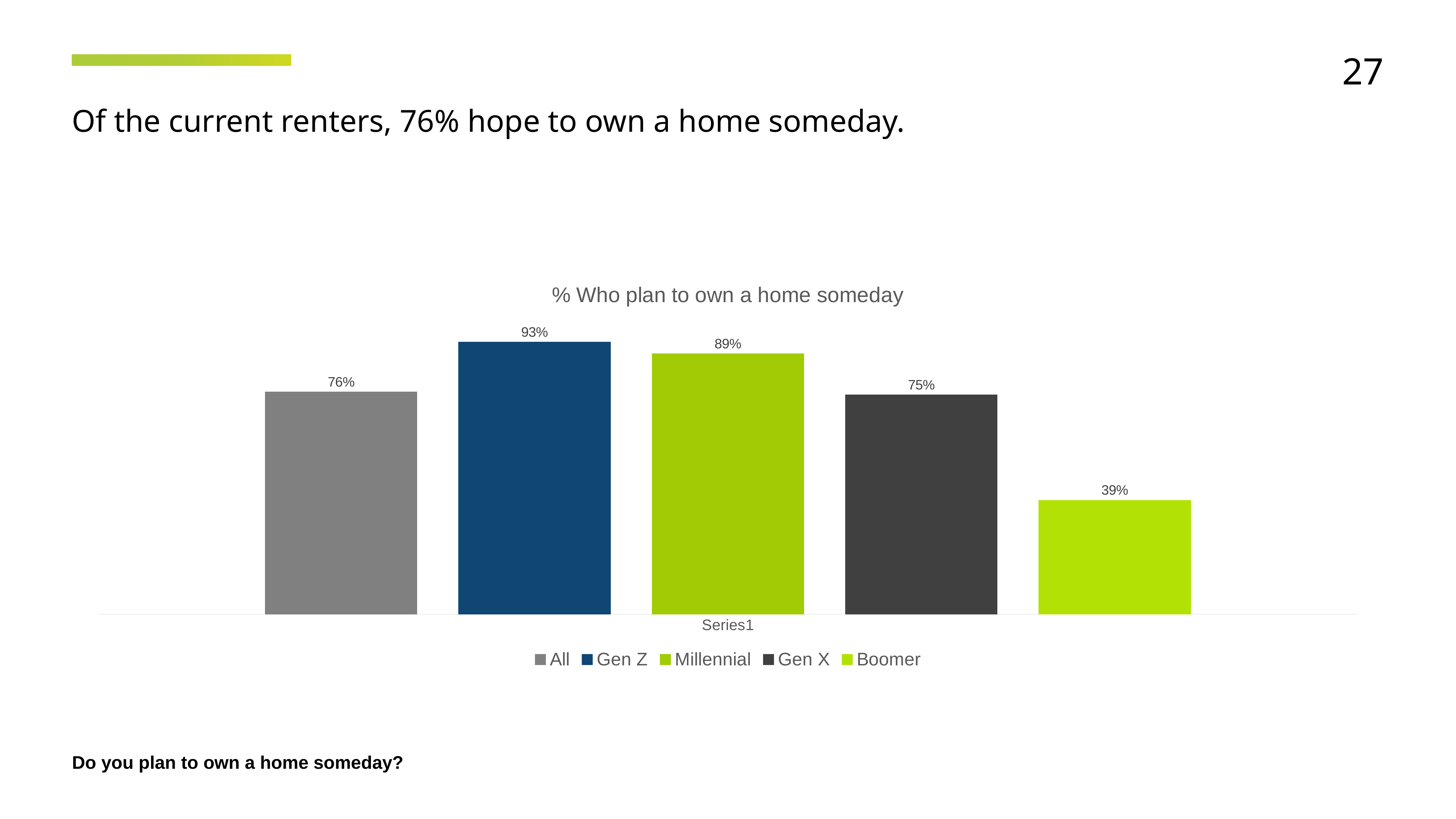
What is the difference between the Gen Z value and the Boomer value? 54% Which group has the lowest percentage who plan to own a home someday? Boomer Which group has the highest percentage who plan to own a home someday? Gen Z What kind of chart is shown on the slide? Bar chart What is the difference between the Millennial value and the Gen X value? 14% What is the value for Gen X? 75% How many bars are shown in the chart? 5 What is the value for Millennial? 89% What is the value for Boomer? 39% What is the value for Gen Z? 93% Which is larger, the value for Gen Z or the value for Millennial? Gen Z What is the title of the chart? % Who plan to own a home someday